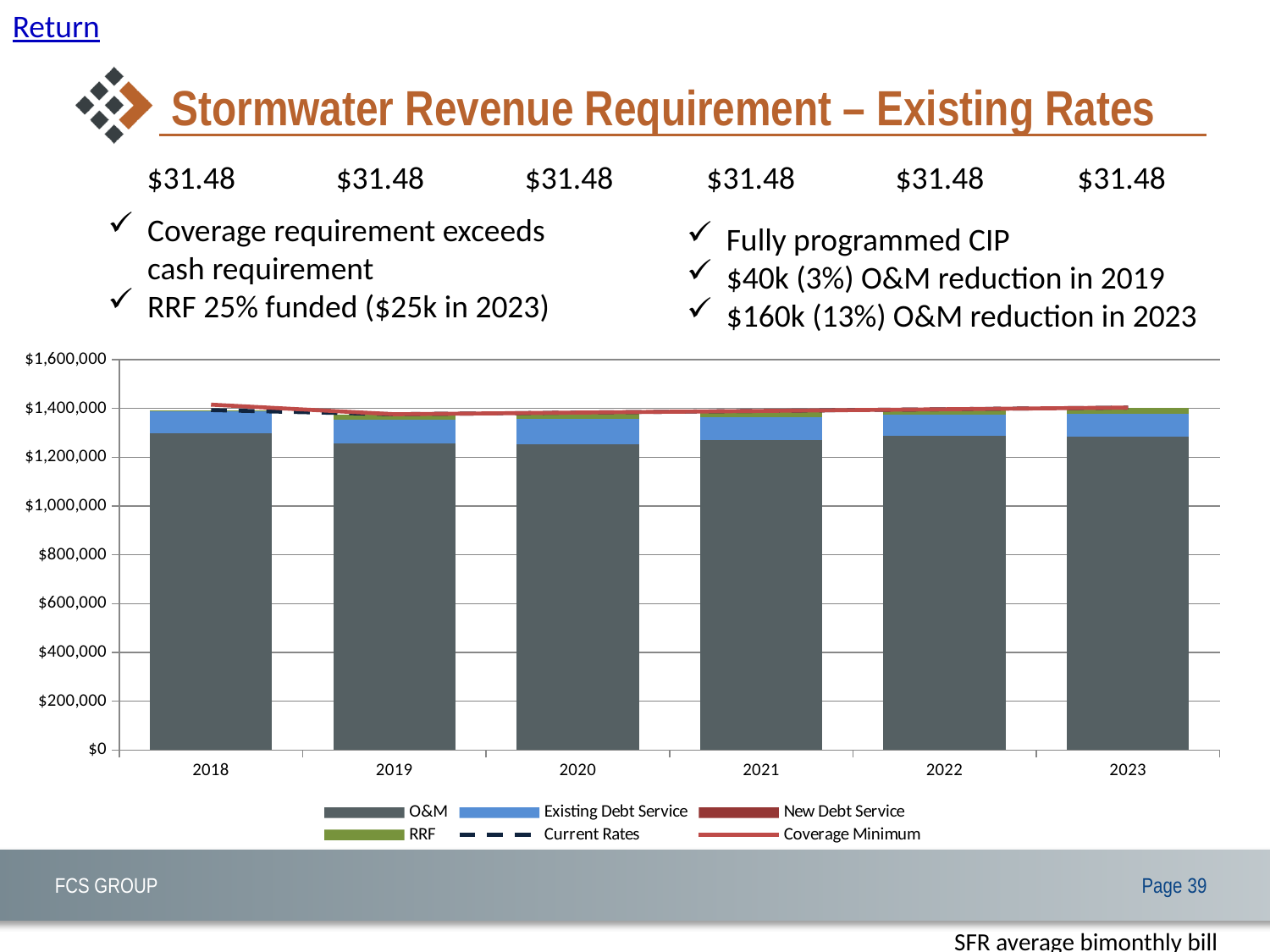
How many years are shown on the x axis of the chart? 6 How many series does the chart legend list? 6 Which is larger, the O&M value for 2018 or the O&M value for 2020? 2018 Is the total height of the stacked bar for 2019 greater or less than $1,400,000? less Which series makes up the largest portion of each stacked bar? O&M What is the title of the slide containing the chart? Stormwater Revenue Requirement – Existing Rates Does the O&M value rise or fall from 2018 to 2019? Fall Which series in the legend is drawn as a dashed line? Current Rates What kind of chart is shown on the slide? A combination chart: stacked bar chart with line series Is the O&M value for 2018 greater or less than $1,200,000? greater Is the total height of the stacked bar for 2023 greater or less than $1,200,000? greater